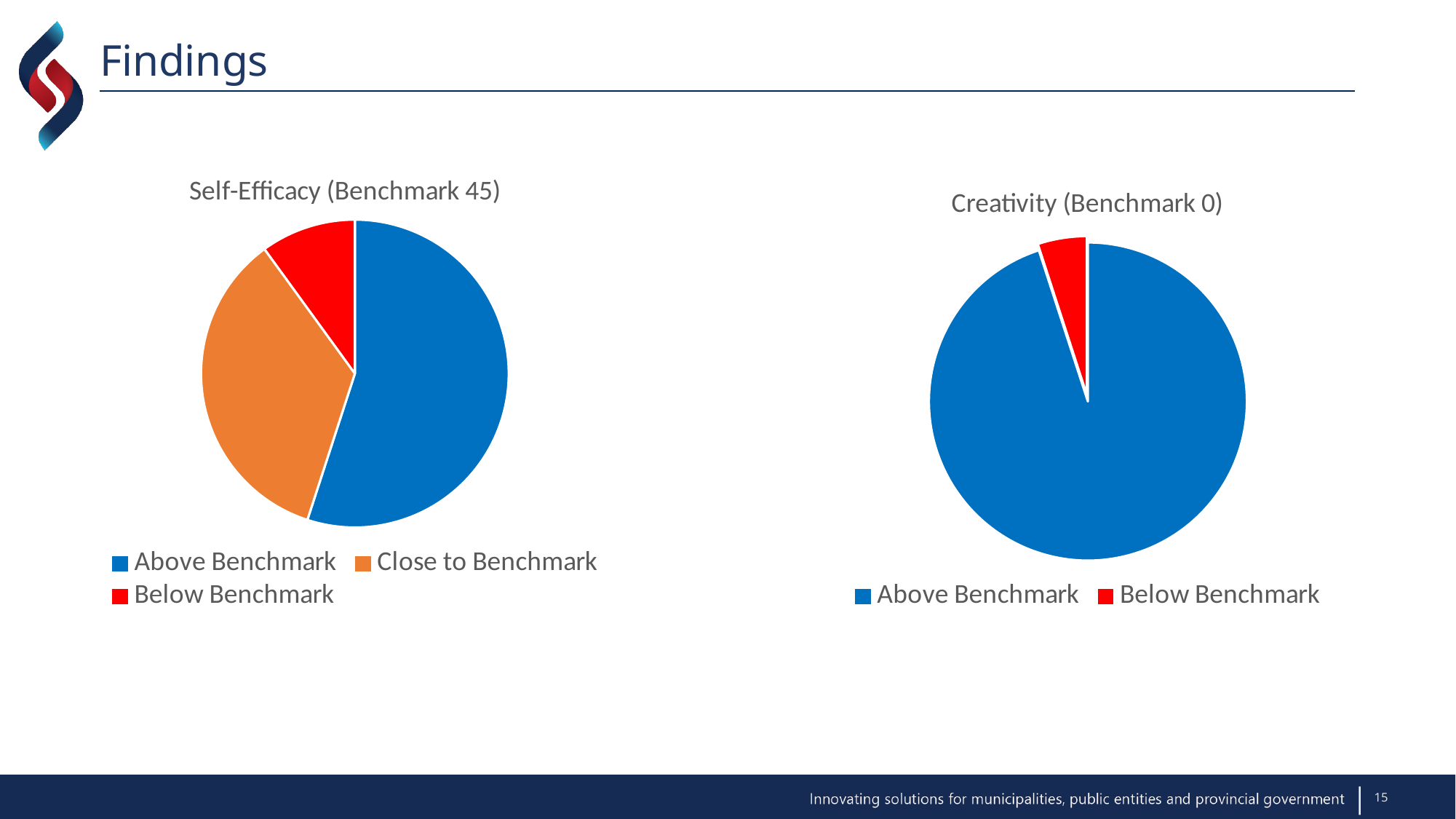
What kind of chart is the "Self-Efficacy (Benchmark 45)" chart? Pie chart In the "Creativity (Benchmark 0)" chart, how many slices does the pie have? 2 In the "Self-Efficacy (Benchmark 45)" chart, which category has the smallest slice? Below Benchmark In the "Creativity (Benchmark 0)" chart, which category has the largest slice? Above Benchmark In the "Self-Efficacy (Benchmark 45)" chart, which slice is larger: Close to Benchmark or Below Benchmark? Close to Benchmark How many entries does the legend of the "Self-Efficacy (Benchmark 45)" chart list? 3 In the "Self-Efficacy (Benchmark 45)" chart, what colour is the Close to Benchmark slice? Orange How many entries does the legend of the "Creativity (Benchmark 0)" chart list? 2 In the "Self-Efficacy (Benchmark 45)" chart, how many slices does the pie have? 3 What kind of chart is the "Creativity (Benchmark 0)" chart? Pie chart In the "Creativity (Benchmark 0)" chart, which slice is larger: Above Benchmark or Below Benchmark? Above Benchmark In the "Self-Efficacy (Benchmark 45)" chart, which category has the largest slice? Above Benchmark